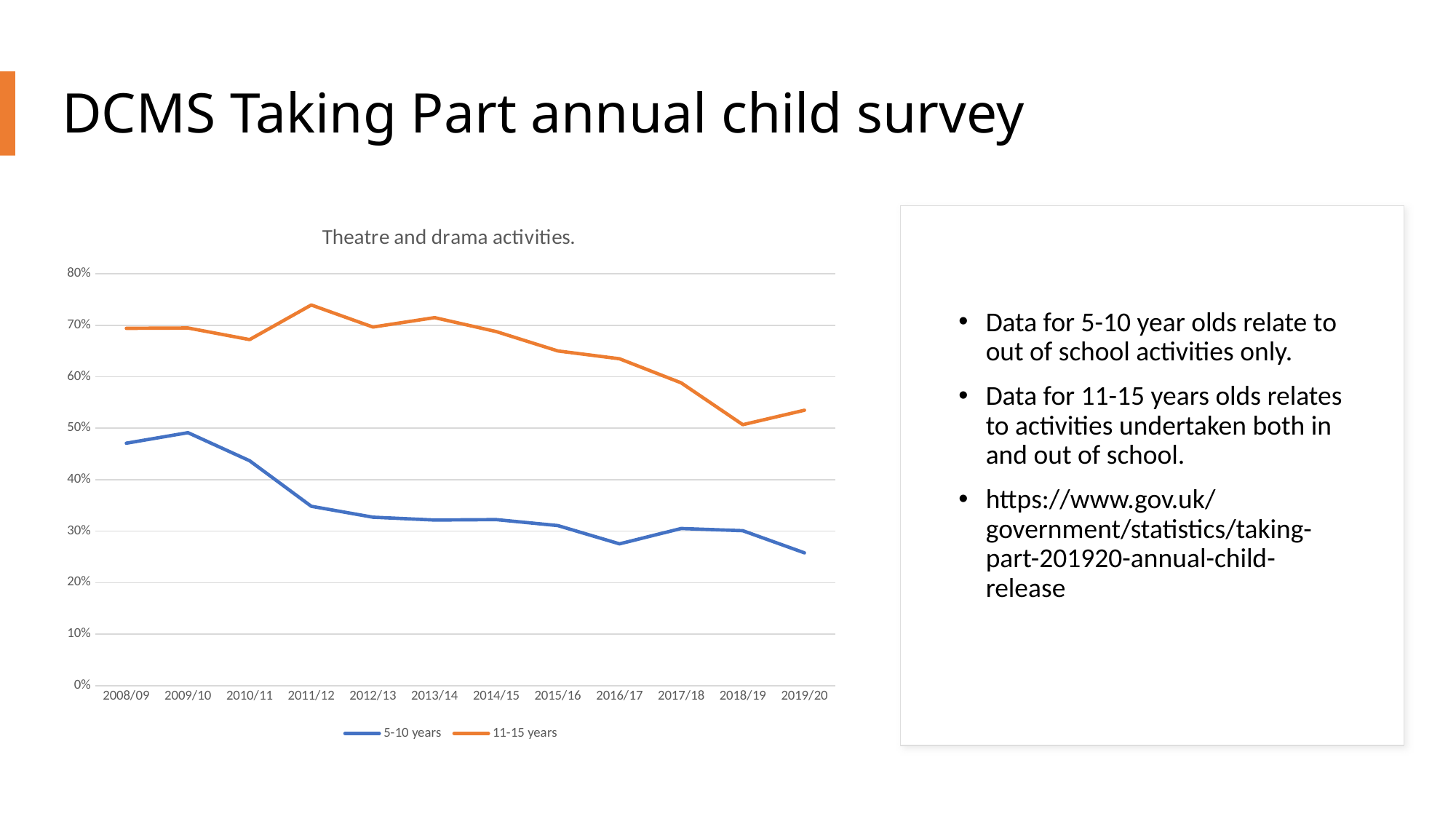
How many series does the legend of the chart list? 2 Is the value for 11-15 years in 2011/12 greater or less than 70%? greater Is the value for 5-10 years in 2011/12 greater or less than 40%? less Which series is drawn in orange in the chart? 11-15 years What is the title of the chart? Theatre and drama activities. In which year is the value for 5-10 years lowest? 2019/20 What kind of chart is shown on the slide? line chart Overall, do the values for 5-10 years rise or fall from 2008/09 to 2019/20? fall In which year is the value for 5-10 years highest? 2009/10 In which year is the value for 11-15 years highest? 2011/12 In which year is the value for 11-15 years lowest? 2018/19 How many years are plotted along the x axis of the chart? 12